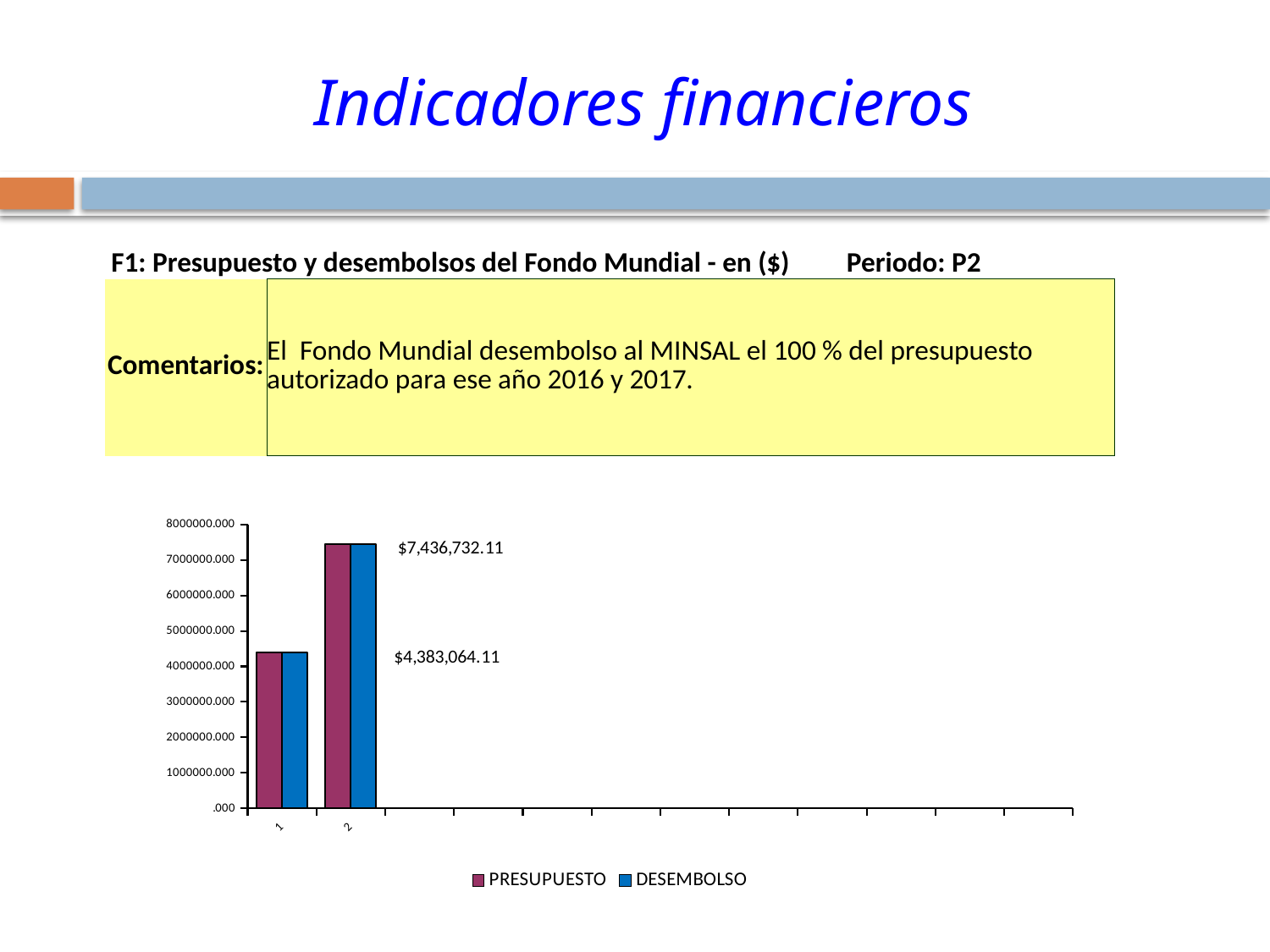
What is the difference between the labelled value for category 2 and the labelled value for category 1? $3,053,668.00 What kind of chart is shown on the slide? bar chart Is the value for category 1 greater or less than 5000000.000? less What value is labelled for category 1 in the chart? $4,383,064.11 Which category has the highest bars in the chart? 2 What are the two series named in the chart legend? PRESUPUESTO and DESEMBOLSO Which category has larger values, 1 or 2? 2 How many series does the chart legend list? 2 What value is labelled for category 2 in the chart? $7,436,732.11 Is the value for category 2 greater or less than 7000000.000? greater How many categories are plotted on the x axis of the chart? 2 Which category has the lowest bars in the chart? 1